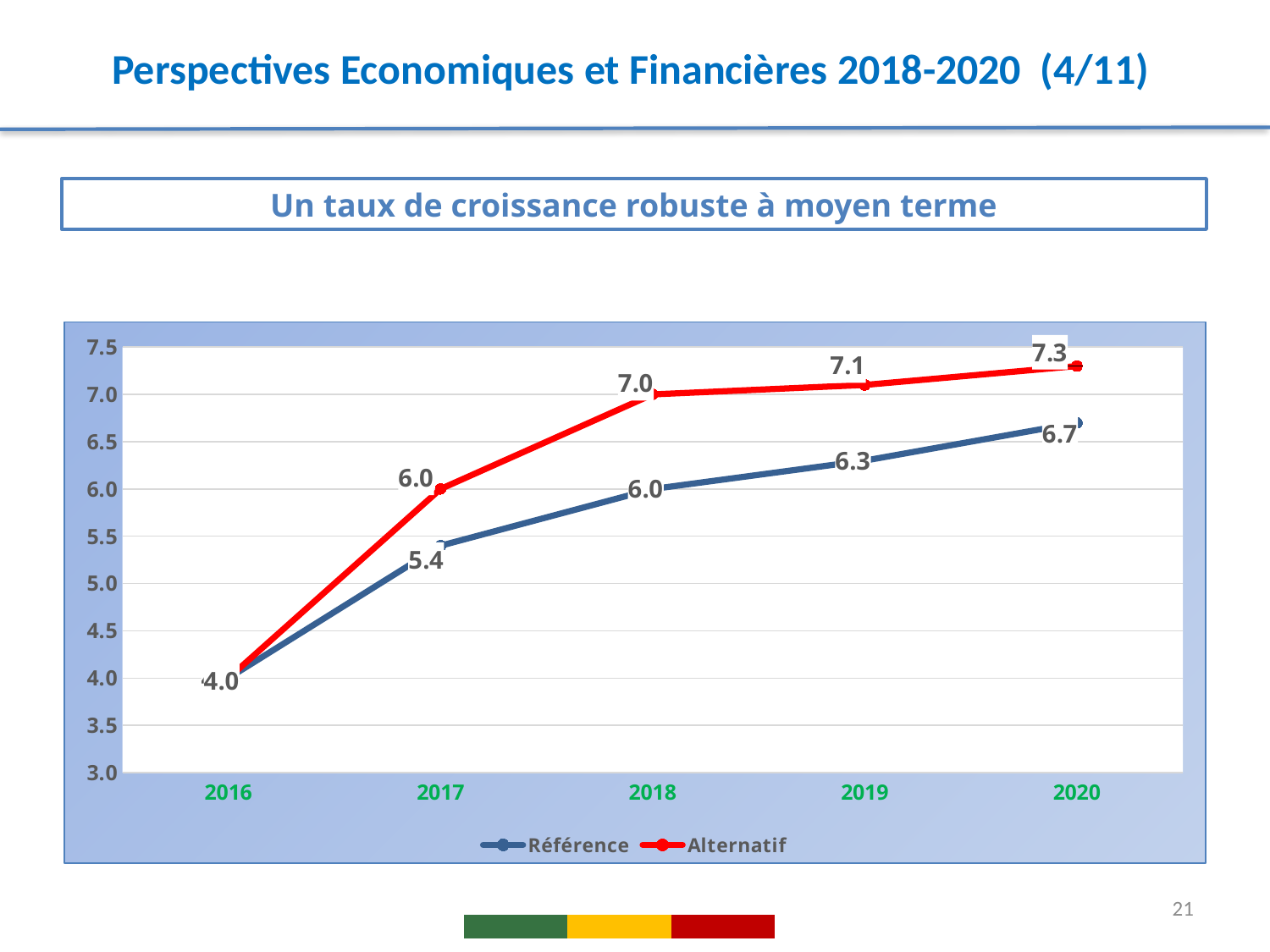
What is the difference between the Alternatif and Référence values in 2020? 0.6 What is the value of the Référence series in 2019? 6.3 How many series does the legend list? 2 What kind of chart is shown on the slide? line chart How many years are plotted along the x axis? 5 What are the two series names shown in the legend? Référence and Alternatif In 2018, which series has the higher value, Référence or Alternatif? Alternatif Do the values of the Alternatif series rise or fall from 2016 to 2020? rise What is the value of the Alternatif series in 2020? 7.3 What is the value of the Référence series in 2017? 5.4 In which year does the Référence series reach its highest value? 2020 What is the value of the Alternatif series in 2018? 7.0